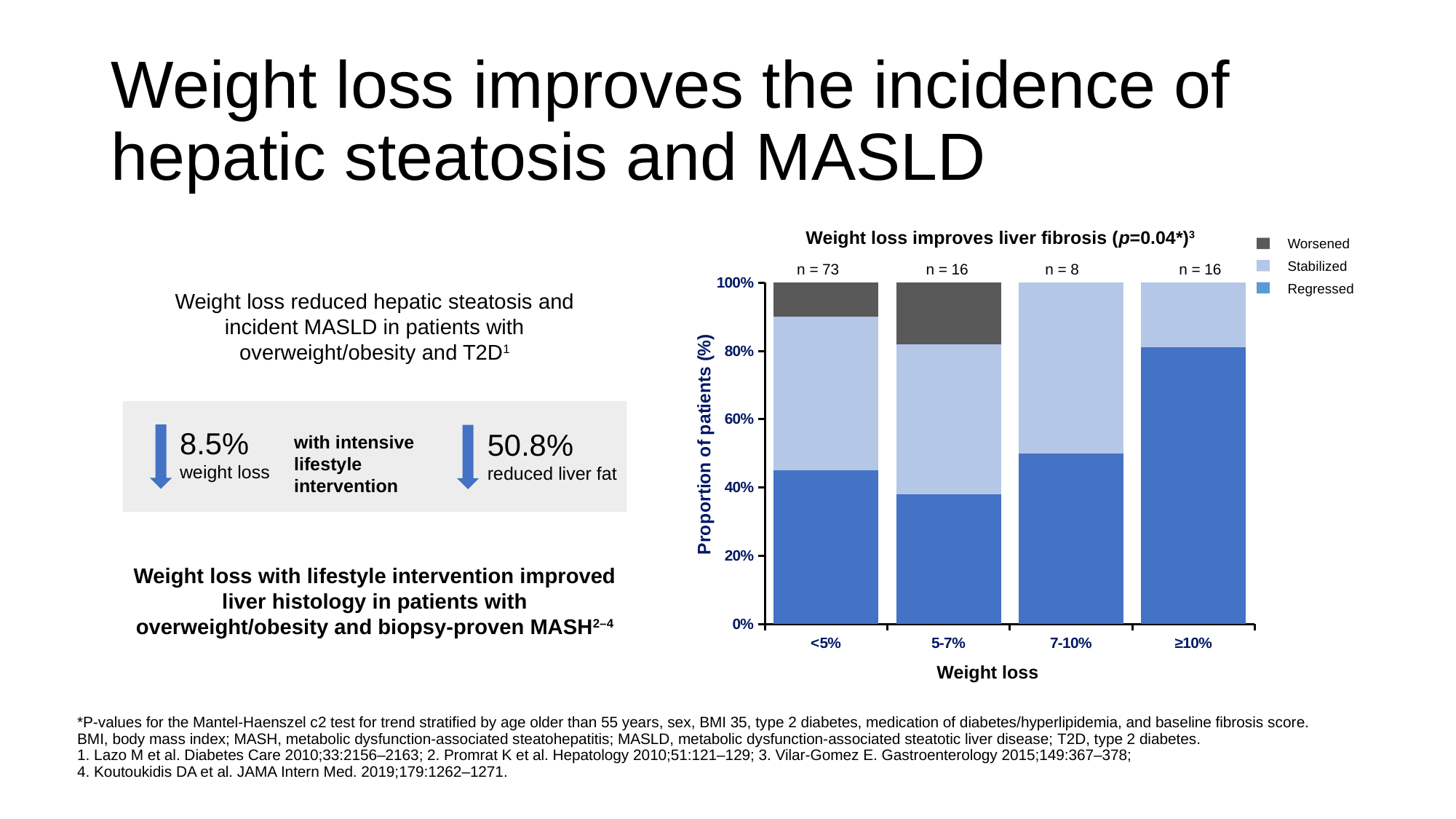
Is the proportion of patients with regressed fibrosis in the ≥10% weight loss group greater or less than 60%? greater What kind of chart is shown on the slide? Stacked bar chart Is the proportion of patients with regressed fibrosis in the <5% weight loss group greater or less than 40%? greater What is the title of the chart? Weight loss improves liver fibrosis (p=0.04*) How many series does the chart legend list? 3 How many weight loss categories are shown on the x axis of the chart? 4 What is the number of patients (n) in the <5% weight loss group? n = 73 Which weight loss group has the largest proportion of patients whose fibrosis worsened? 5-7% Which group has a larger proportion of regressed fibrosis, <5% or ≥10% weight loss? ≥10% Which weight loss group has the largest proportion of patients whose fibrosis regressed? ≥10% What is the number of patients (n) in the 7-10% weight loss group? n = 8 Which weight loss group has the largest number of patients (n)? <5%